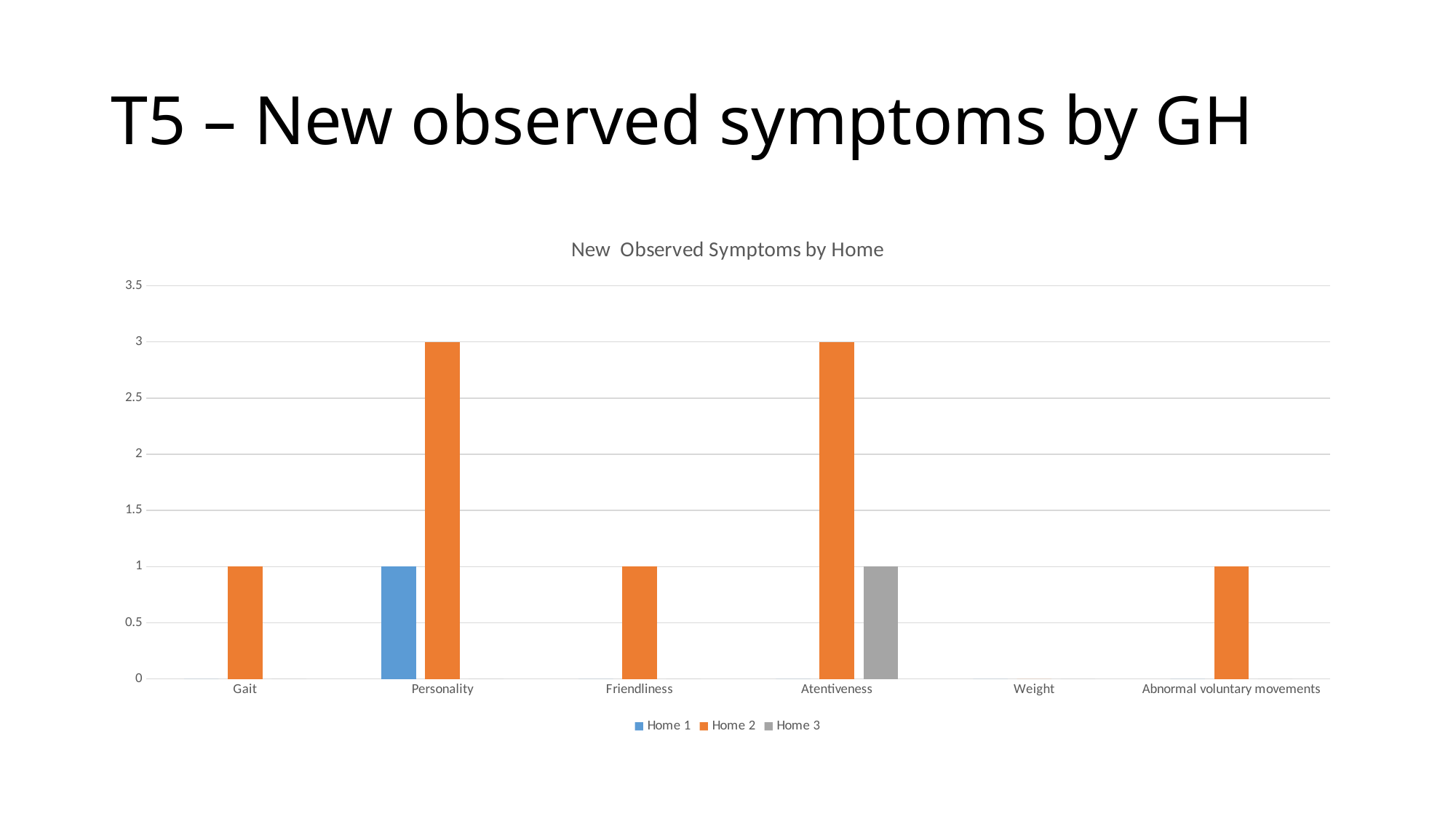
What is the title of the chart? New Observed Symptoms by Home What is the value for Home 2 in the Personality category? 3 What is the value for Home 2 in the Atentiveness category? 3 Which is larger in the Atentiveness category, the Home 2 value or the Home 3 value? Home 2 What is the value for Home 1 in the Personality category? 1 How many series does the legend list? 3 What is the difference between the Home 2 and Home 1 values in the Personality category? 2 What is the value for Home 3 in the Atentiveness category? 1 How many symptom categories are shown on the x axis? 6 Which category has no bars at all? Weight What type of chart is shown on the slide? bar chart What is the value for Home 2 in the Gait category? 1